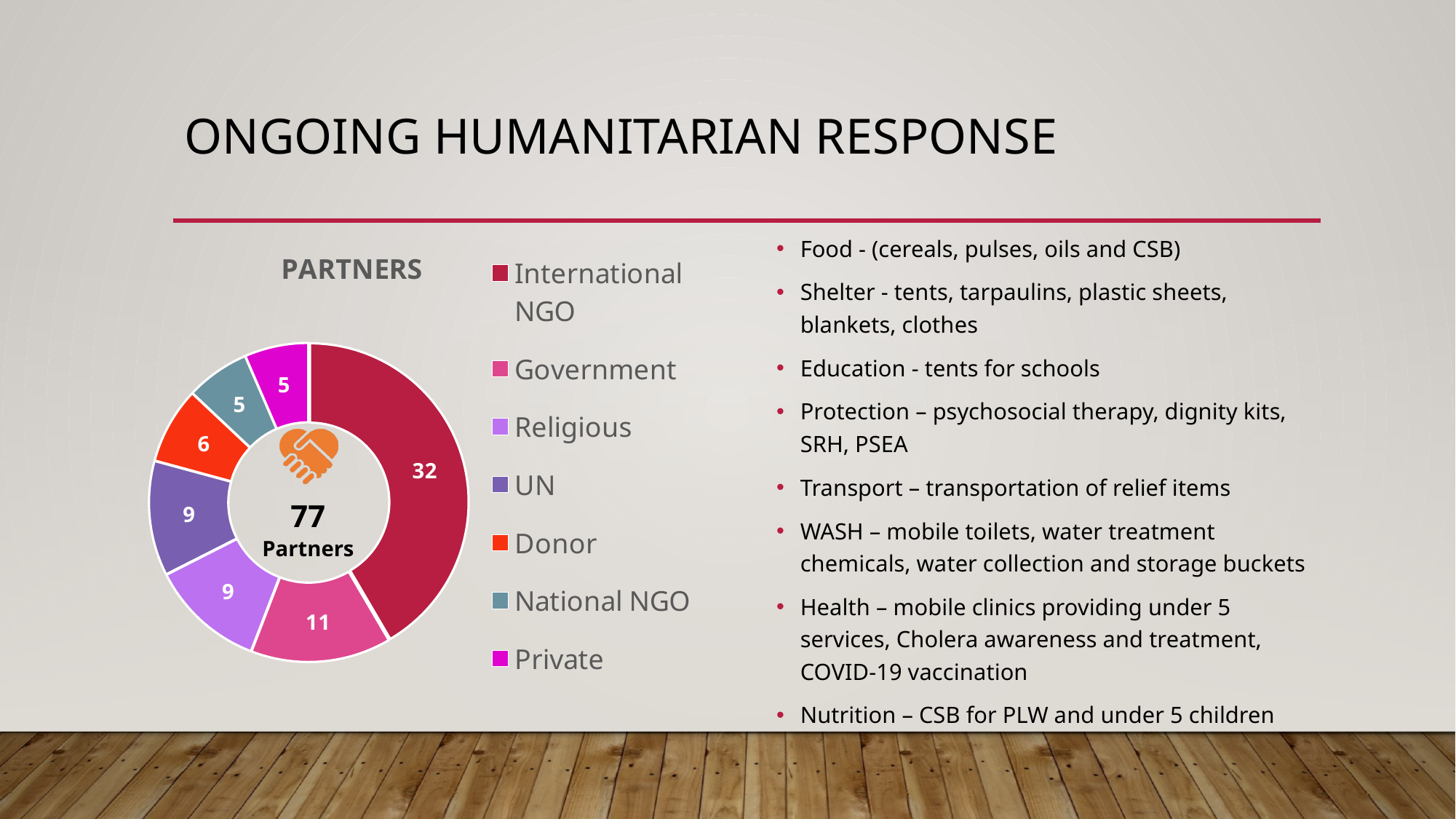
What type of chart is shown under the heading PARTNERS? doughnut chart In the PARTNERS chart, which is larger: Government or Donor? Government What is the difference between the Religious and National NGO values in the PARTNERS chart? 4 Which category has the largest value in the PARTNERS chart? International NGO What total number of partners is shown in the centre of the PARTNERS chart? 77 How many categories does the PARTNERS chart show? 7 In the PARTNERS chart, what is the value for UN? 9 What is the difference between the International NGO and Government values in the PARTNERS chart? 21 Which legend entry in the PARTNERS chart is shown in magenta? Private In the PARTNERS chart, what is the value for Donor? 6 In the PARTNERS chart, what is the value for Government? 11 In the PARTNERS chart, what is the value for International NGO? 32